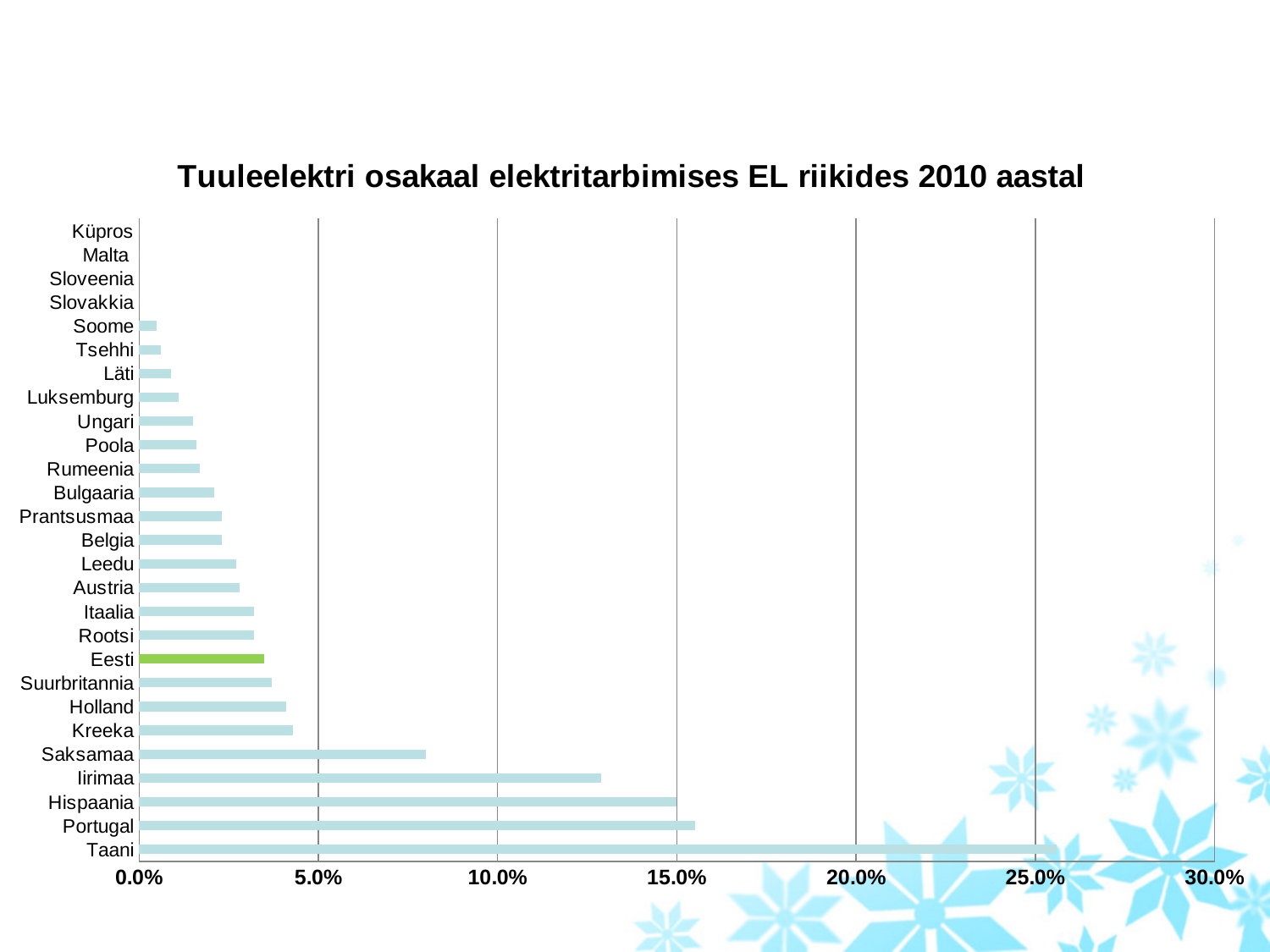
Is the value for Iirimaa greater or less than 15.0%? less What kind of chart is shown on the slide? bar chart Is the value for Saksamaa greater or less than 10.0%? less Which country has the highest value in the chart? Taani Which country's bar is highlighted in green in the chart? Eesti Is the value for Taani greater or less than 20.0%? greater Which has the larger value, Iirimaa or Saksamaa? Iirimaa What is the title of the chart? Tuuleelektri osakaal elektritarbimises EL riikides 2010 aastal How many countries are listed on the vertical axis of the chart? 27 Which has the larger value, Taani or Portugal? Taani